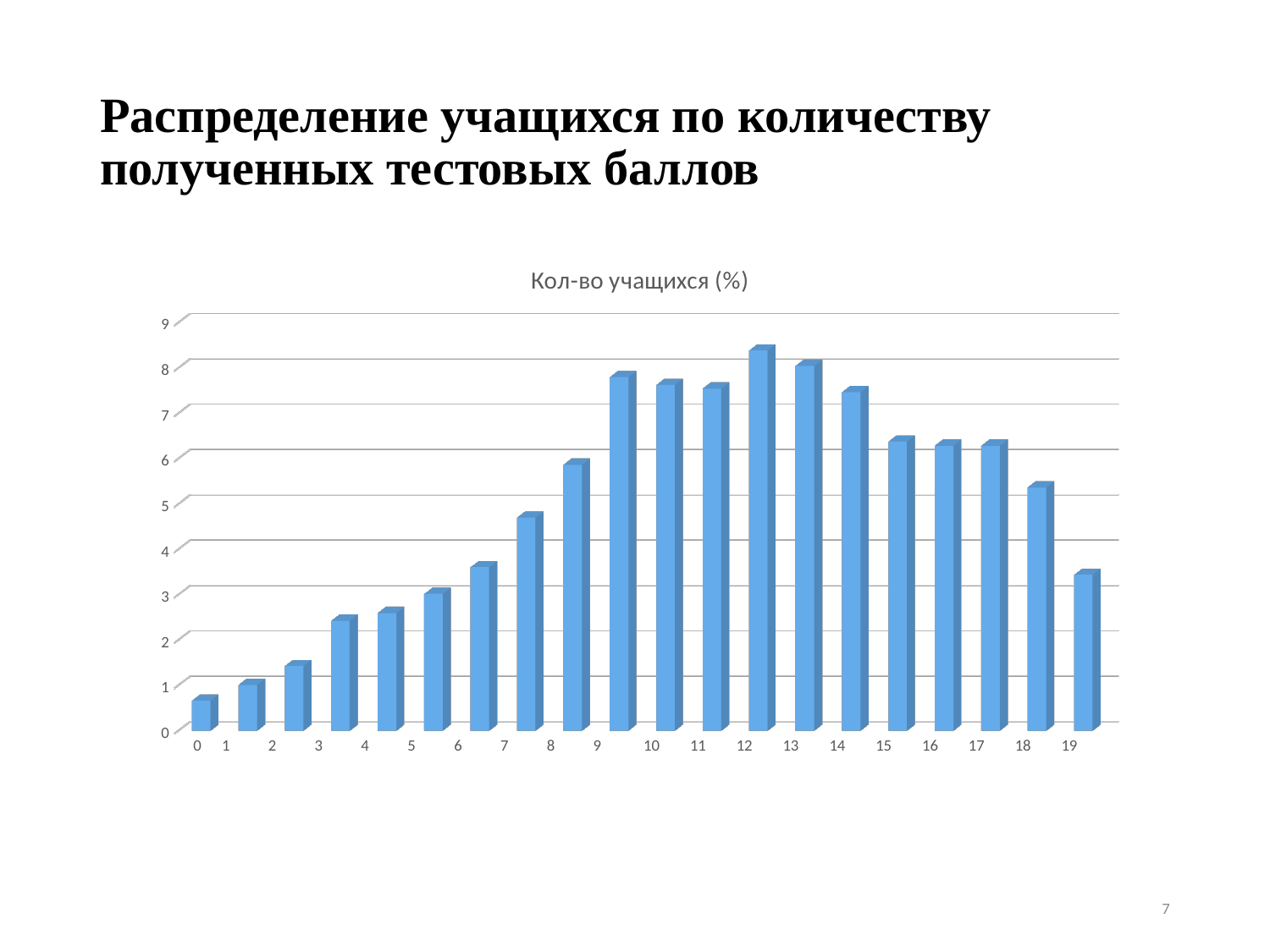
Is the value for score 19 greater or less than 4? less How many score categories are shown on the x axis? 20 Which has the larger value, score 9 or score 5? 9 Is the value for score 8 greater or less than 5? greater Do the values rise or fall from score 0 to score 12? rise What kind of chart is shown on the slide? bar chart Is the value for score 12 greater or less than 8? greater What is the title of the chart? Кол-во учащихся (%) Which score category has the highest bar? 12 Which score category has the lowest bar? 0